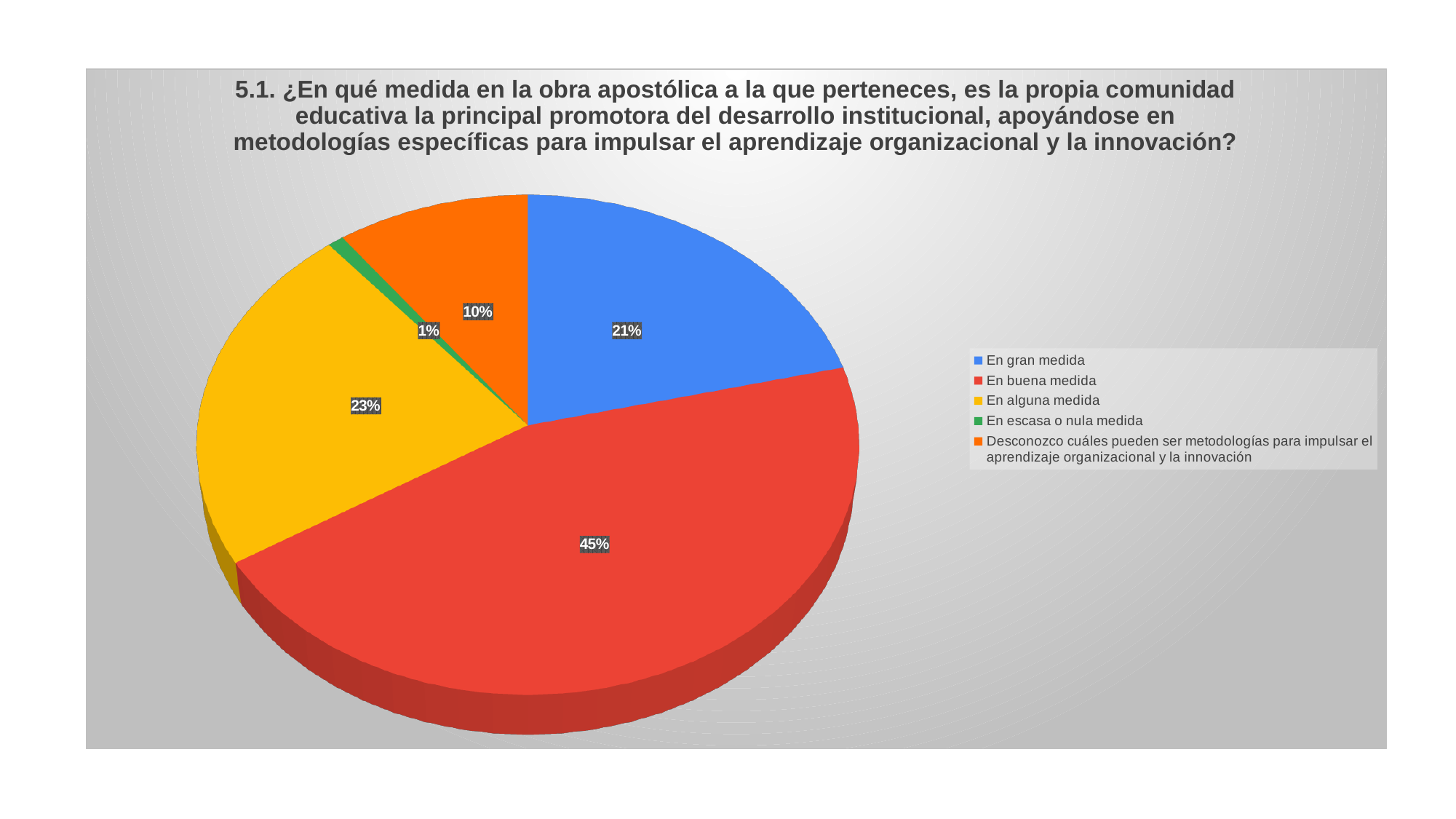
Which category has the smallest slice of the pie? En escasa o nula medida Which is larger, the slice for "En alguna medida" or the slice for "En gran medida"? En alguna medida What share of the pie does "Desconozco cuáles pueden ser metodologías para impulsar el aprendizaje organizacional y la innovación" represent? 10% What colour is the slice for "En alguna medida"? Yellow Which category has the largest slice of the pie? En buena medida How many categories does the legend list? 5 What is the difference in percentage points between "En buena medida" and "En gran medida"? 24 What share of the pie does "En gran medida" represent? 21% What share of the pie does "En escasa o nula medida" represent? 1% What kind of chart is shown on the slide? Pie chart